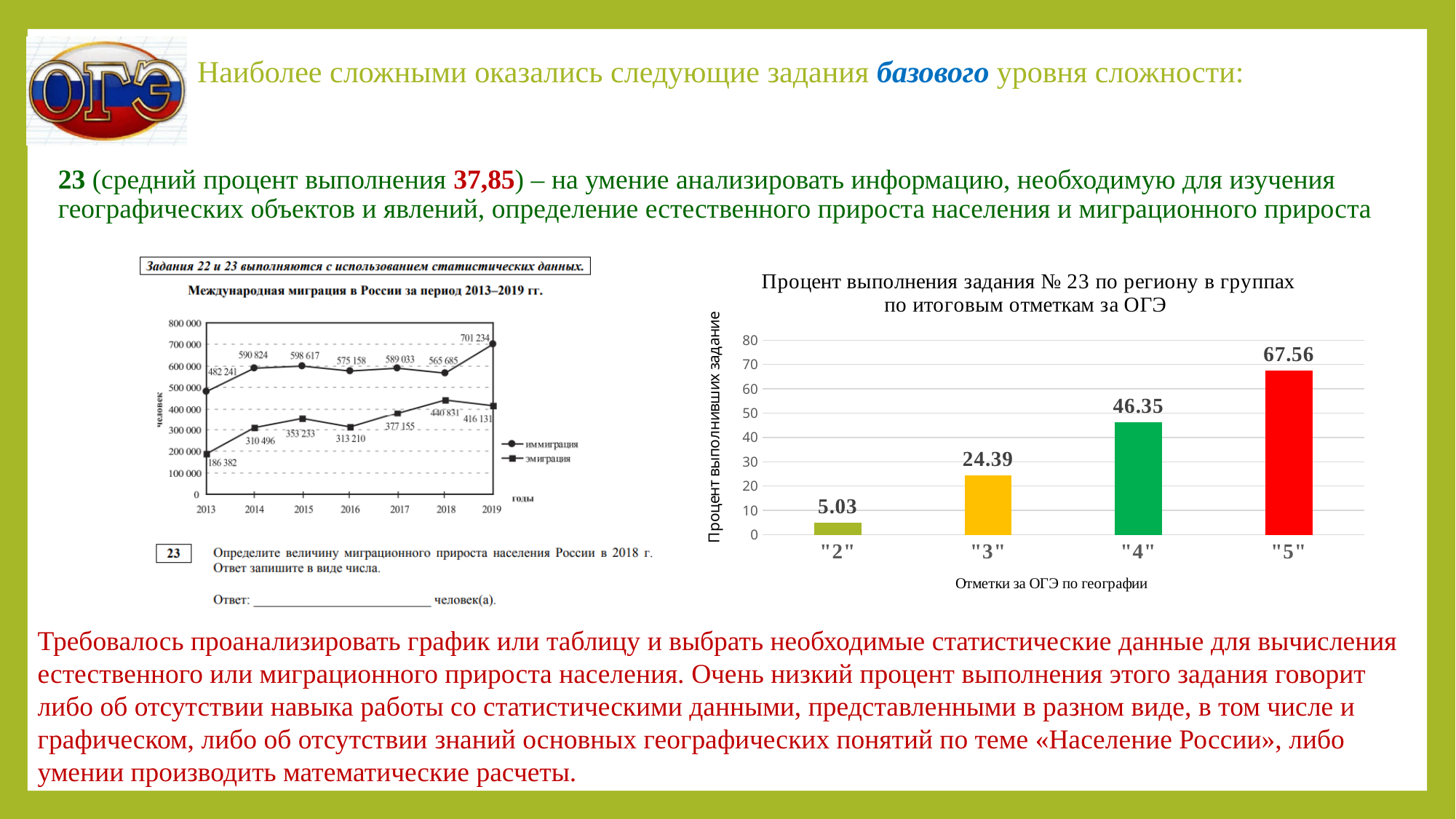
On the bar chart on the right, what is the difference between the values for the "5" and "4" groups? 21.21 On the bar chart on the right, what is the value for the "3" grade group? 24.39 On the line chart on the left (Международная миграция в России), how many series does the legend list? 2 On the bar chart on the right, do the values rise or fall from "2" to "5"? rise What kind of chart is the chart on the right of the slide? bar chart On the line chart on the left (Международная миграция в России), what is the immigration value for 2019? 701 234 On the line chart on the left (Международная миграция в России), what is the difference between immigration and emigration in 2018? 124 854 On the bar chart on the right, how many grade groups are shown? 4 On the bar chart on the right, which grade group has the lowest completion percentage? "2" On the bar chart on the right, which grade group has the highest completion percentage? "5" On the line chart on the left (Международная миграция в России), what is the emigration value for 2018? 440 831 On the line chart on the left (Международная миграция в России), which is larger in 2013: immigration or emigration? immigration